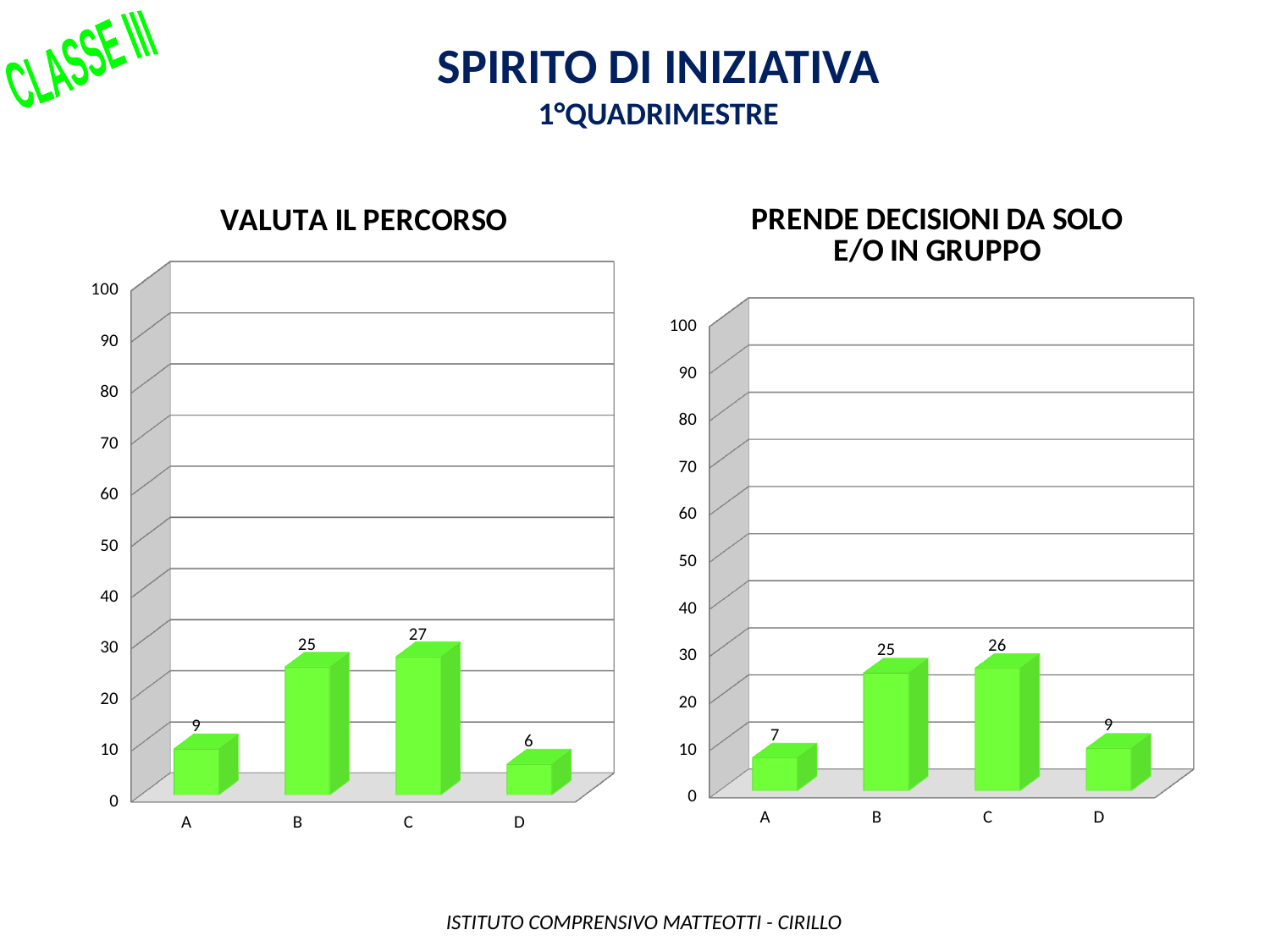
In the 'PRENDE DECISIONI DA SOLO E/O IN GRUPPO' chart, is the value for B greater or less than 20? greater In the 'VALUTA IL PERCORSO' chart, what is the value for category D? 6 In the 'VALUTA IL PERCORSO' chart, what is the difference between the values for C and B? 2 In the 'VALUTA IL PERCORSO' chart, which category has the lowest value? D In the 'PRENDE DECISIONI DA SOLO E/O IN GRUPPO' chart, what is the value for category A? 7 What kind of chart is the 'PRENDE DECISIONI DA SOLO E/O IN GRUPPO' chart? bar chart In the 'PRENDE DECISIONI DA SOLO E/O IN GRUPPO' chart, what is the difference between the values for B and A? 18 How many categories are shown in the 'VALUTA IL PERCORSO' chart? 4 In the 'PRENDE DECISIONI DA SOLO E/O IN GRUPPO' chart, which category has the highest value? C What is the title of the chart on the left side of the slide? VALUTA IL PERCORSO In the 'VALUTA IL PERCORSO' chart, which is larger, the value for A or the value for D? A In the 'VALUTA IL PERCORSO' chart, what is the value for category C? 27